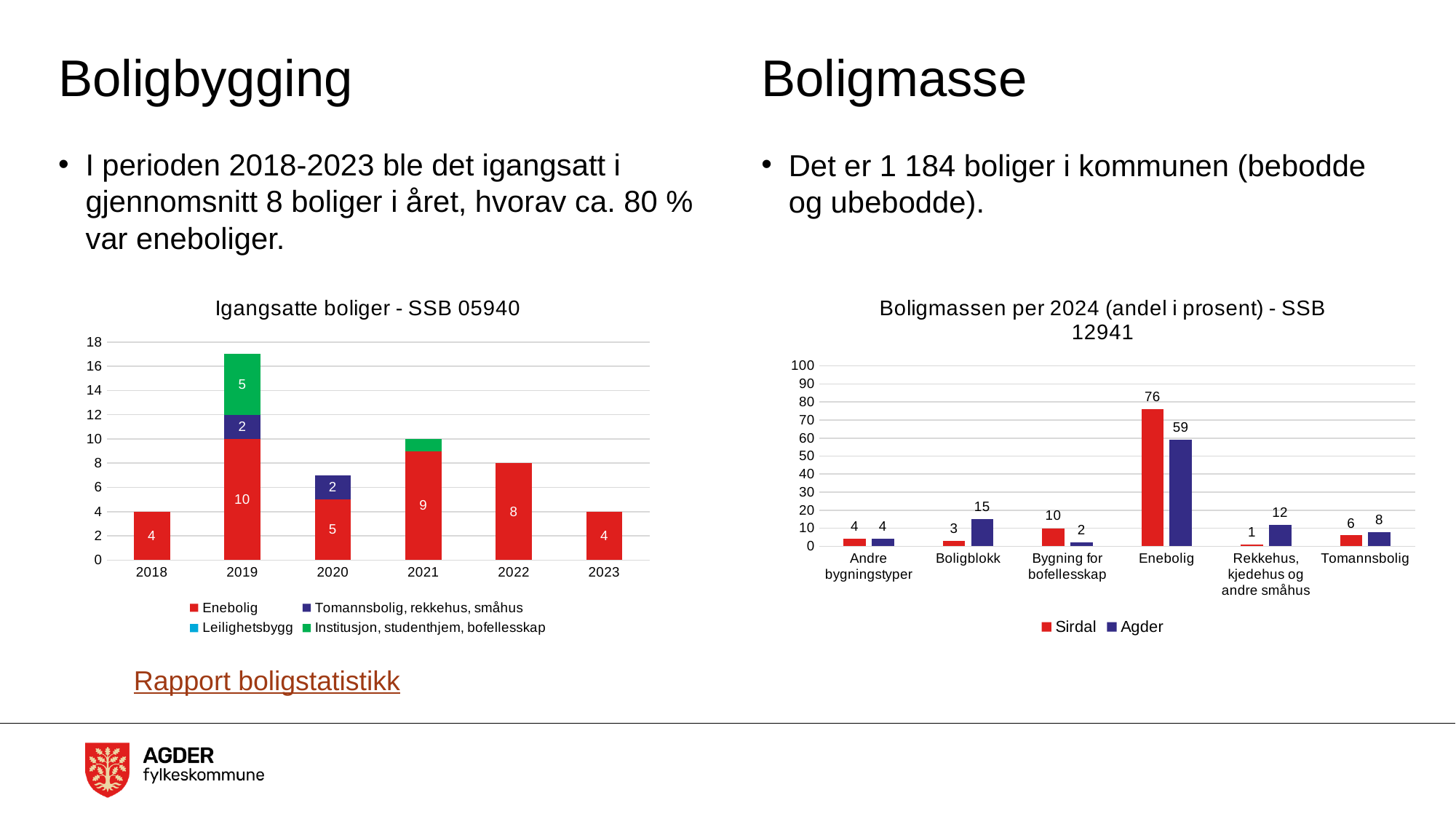
In the chart 'Igangsatte boliger - SSB 05940', how many series does the legend list? 4 In the chart 'Boligmassen per 2024 (andel i prosent) - SSB 12941', which category has the lowest Sirdal value? Rekkehus, kjedehus og andre småhus In the chart 'Igangsatte boliger - SSB 05940', what is the Enebolig value for 2019? 10 What kind of chart is 'Boligmassen per 2024 (andel i prosent) - SSB 12941'? Bar chart In the chart 'Boligmassen per 2024 (andel i prosent) - SSB 12941', what is the Agder value for Boligblokk? 15 In the chart 'Boligmassen per 2024 (andel i prosent) - SSB 12941', what is the Sirdal value for Enebolig? 76 In the chart 'Boligmassen per 2024 (andel i prosent) - SSB 12941', which is larger for Bygning for bofellesskap, Sirdal or Agder? Sirdal In the chart 'Igangsatte boliger - SSB 05940', which year has the highest total bar? 2019 In the chart 'Igangsatte boliger - SSB 05940', what is the total of the stacked bar for 2019? 17 In the chart 'Boligmassen per 2024 (andel i prosent) - SSB 12941', what is the difference between the Sirdal and Agder values for Enebolig? 17 In the chart 'Igangsatte boliger - SSB 05940', what is the total of the stacked bar for 2020? 7 In the chart 'Igangsatte boliger - SSB 05940', how many years are shown on the x axis? 6